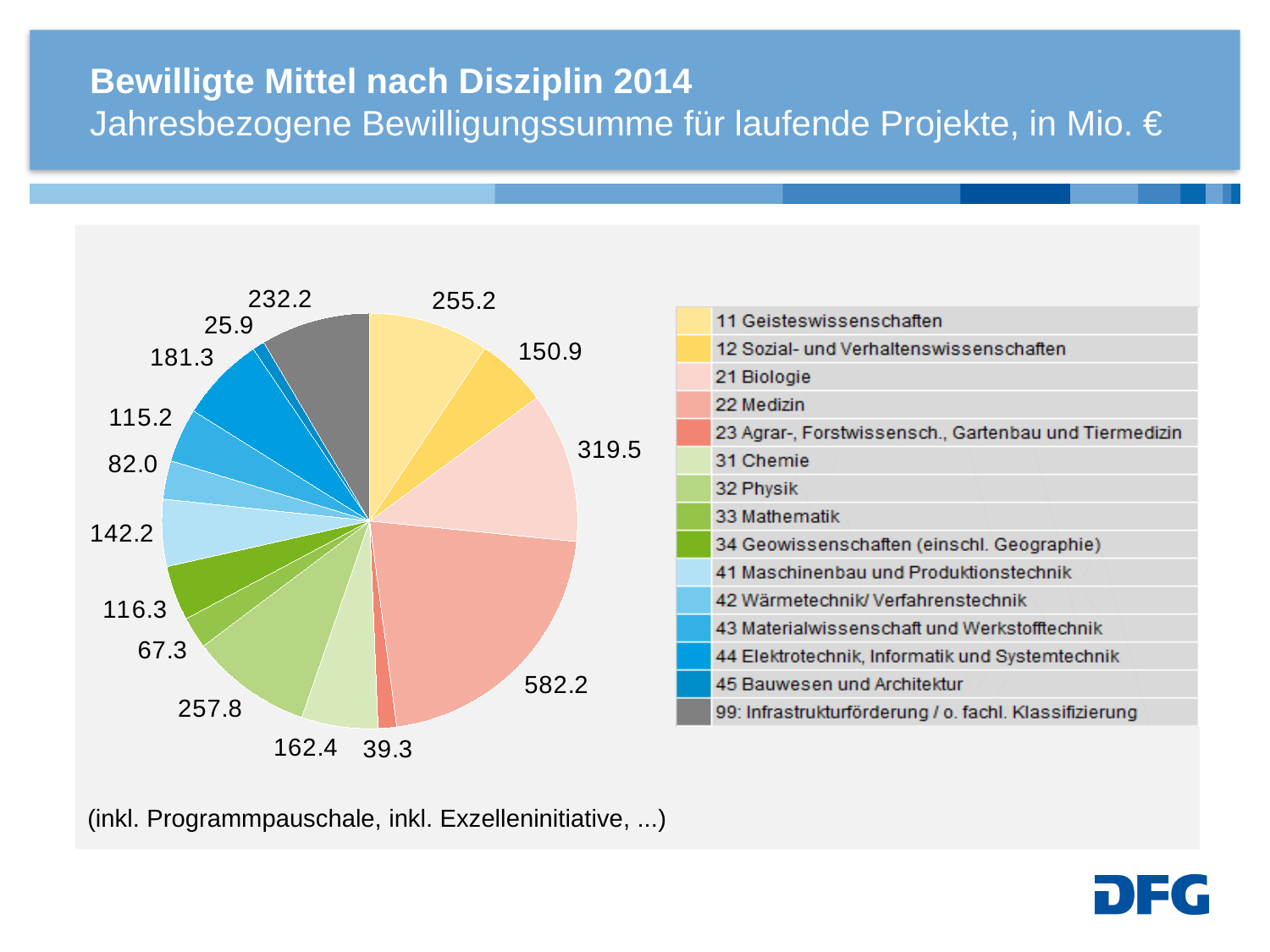
What is the difference between the values for 22 Medizin and 21 Biologie? 262.7 Which discipline has the largest slice of the pie? 22 Medizin What is the value for 99: Infrastrukturförderung / o. fachl. Klassifizierung? 232.2 What kind of chart is shown on the slide? pie chart Which discipline has the smallest slice of the pie? 45 Bauwesen und Architektur What is the value for 11 Geisteswissenschaften? 255.2 What is the title of the chart on the slide? Bewilligte Mittel nach Disziplin 2014 How many slices does the pie chart have? 15 What is the value for 22 Medizin? 582.2 Which is larger, the value for 32 Physik or the value for 11 Geisteswissenschaften? 32 Physik How many entries does the legend list? 15 What is the value for 44 Elektrotechnik, Informatik und Systemtechnik? 181.3